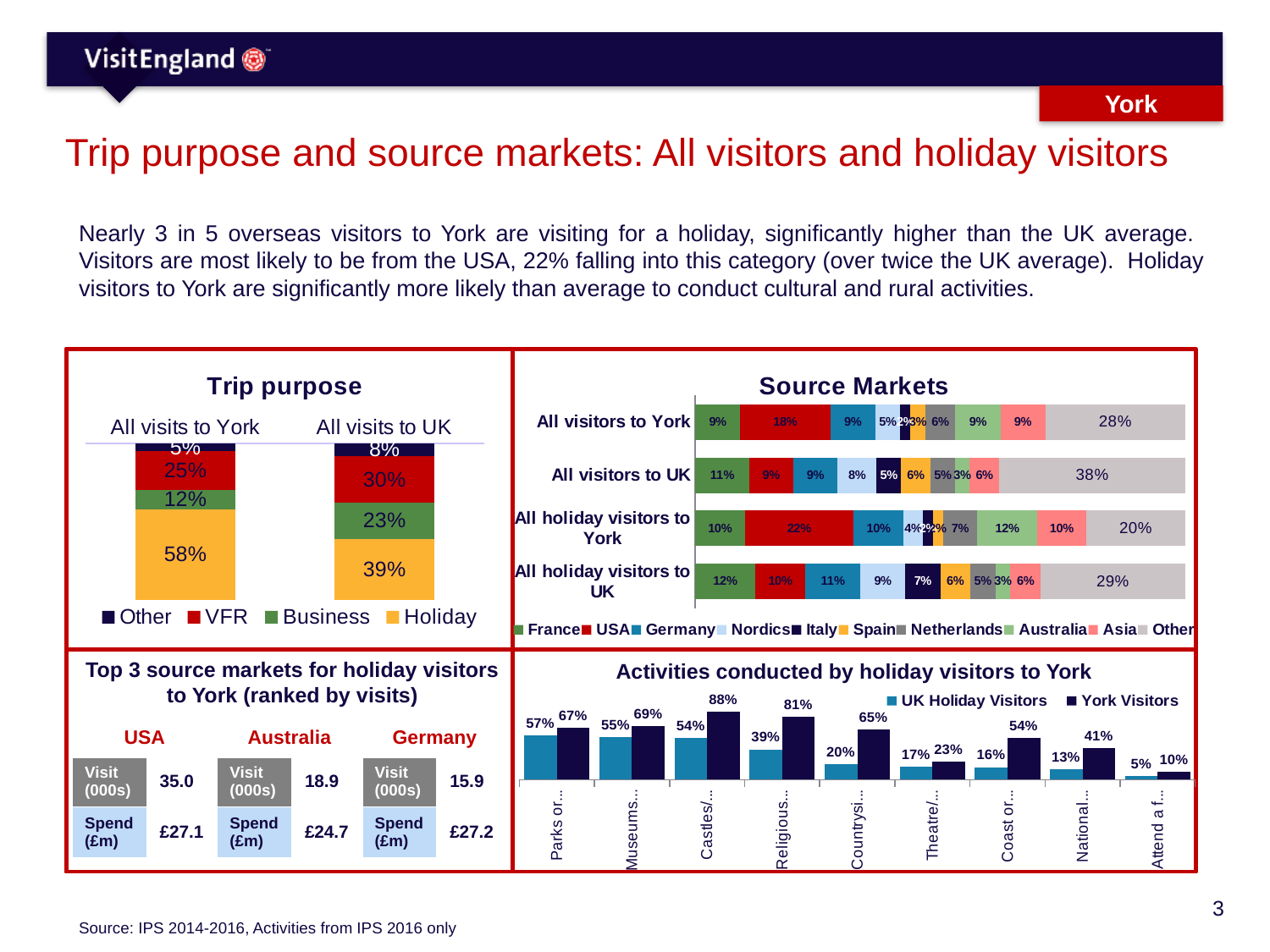
In the Trip purpose chart, which is larger: the VFR share for all visits to York or for all visits to UK? All visits to UK In the Source Markets chart, what percentage of all holiday visitors to York come from the USA? 22% In the Activities conducted by holiday visitors to York chart, which activity has the highest York Visitors value? Castles How many bars (visitor groups) are shown in the Source Markets chart? 4 In the Activities conducted by holiday visitors to York chart, what is the York Visitors value for Castles? 88% In the Activities conducted by holiday visitors to York chart, what is the difference between York Visitors and UK Holiday Visitors for Religious sites? 42 percentage points In the Trip purpose chart, what is the difference between the Holiday share for all visits to York and for all visits to UK? 19 percentage points How many series does the legend of the Source Markets chart list? 10 In the Trip purpose chart, what percentage of all visits to UK are for Business? 23% In the Source Markets chart, what is the 'Other' share for all visitors to UK? 38% How many series does the legend of the Trip purpose chart list? 4 In the Trip purpose chart, what percentage of all visits to York are for Holiday? 58%